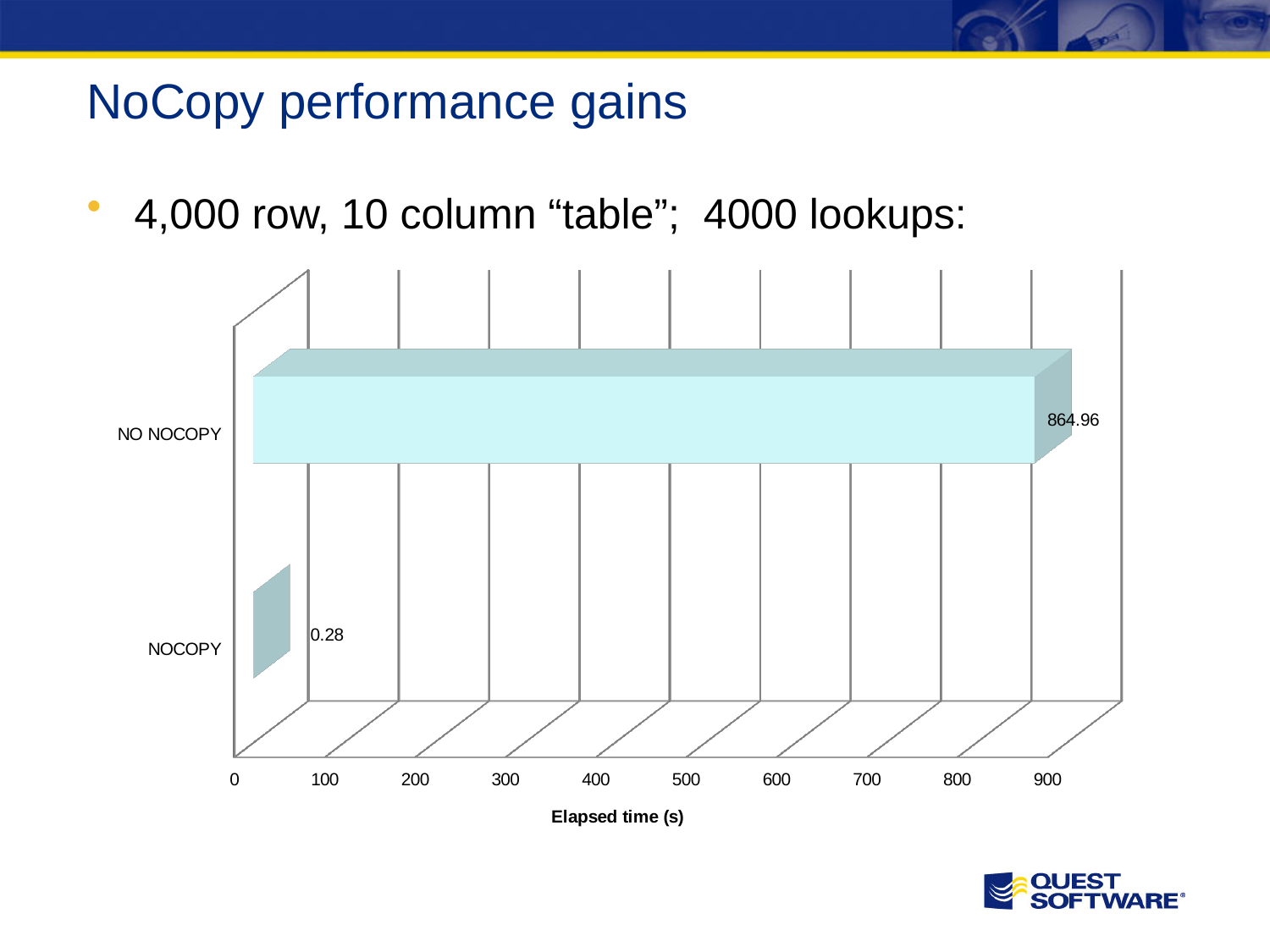
What is the highest value shown on the horizontal axis? 900 Which category has the highest elapsed time? NO NOCOPY What kind of chart is shown on the slide? bar chart How many categories are shown in the chart? 2 What is the label of the horizontal axis? Elapsed time (s) What is the difference in elapsed time between NO NOCOPY and NOCOPY? 864.68 What is the elapsed time for NOCOPY? 0.28 What is the elapsed time for NO NOCOPY? 864.96 Is the elapsed time for NO NOCOPY greater or less than 800? greater Is the elapsed time for NOCOPY greater or less than 100? less Which has a larger elapsed time, NOCOPY or NO NOCOPY? NO NOCOPY Which category has the lowest elapsed time? NOCOPY